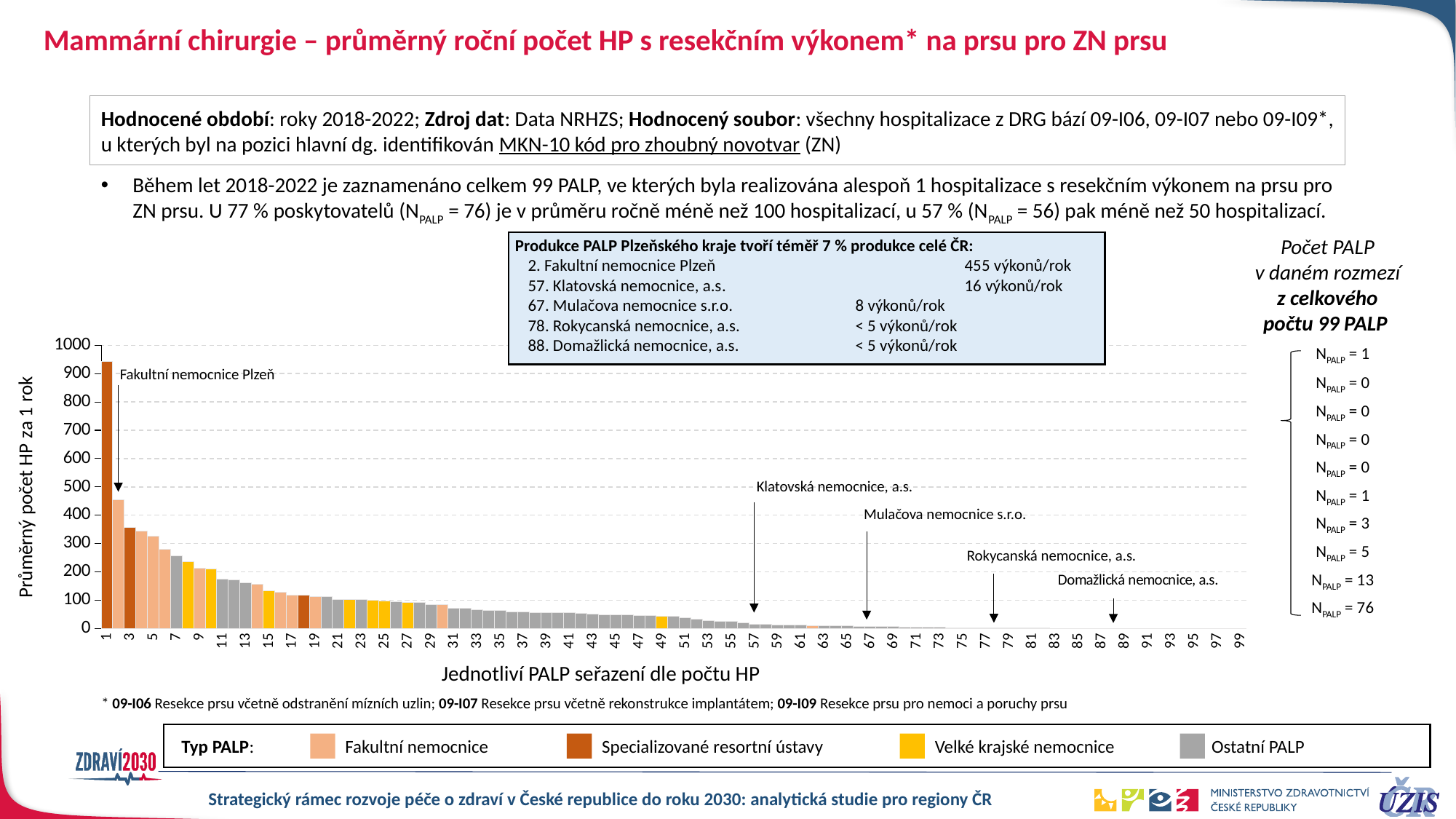
According to the box on the chart, how many výkonů/rok does Klatovská nemocnice, a.s. have? 16 výkonů/rok Is the value for Fakultní nemocnice Plzeň greater or less than 500? less Which has more výkonů/rok, Klatovská nemocnice, a.s. or Mulačova nemocnice s.r.o.? Klatovská nemocnice, a.s. How many PALP types does the legend 'Typ PALP' list? 4 According to the box on the chart, how many výkonů/rok does Mulačova nemocnice s.r.o. have? 8 výkonů/rok Is the value of the first (tallest) bar greater or less than 900? greater What kind of chart is shown on the slide? bar chart What is the difference in výkonů/rok between Fakultní nemocnice Plzeň and Klatovská nemocnice, a.s.? 439 Do the bar values rise or fall from left to right along the x axis? fall How many PALP (bars) are plotted along the x axis of the chart? 99 What is the title of the y axis of the chart? Průměrný počet HP za 1 rok According to the box on the chart, how many výkonů/rok does Fakultní nemocnice Plzeň have? 455 výkonů/rok